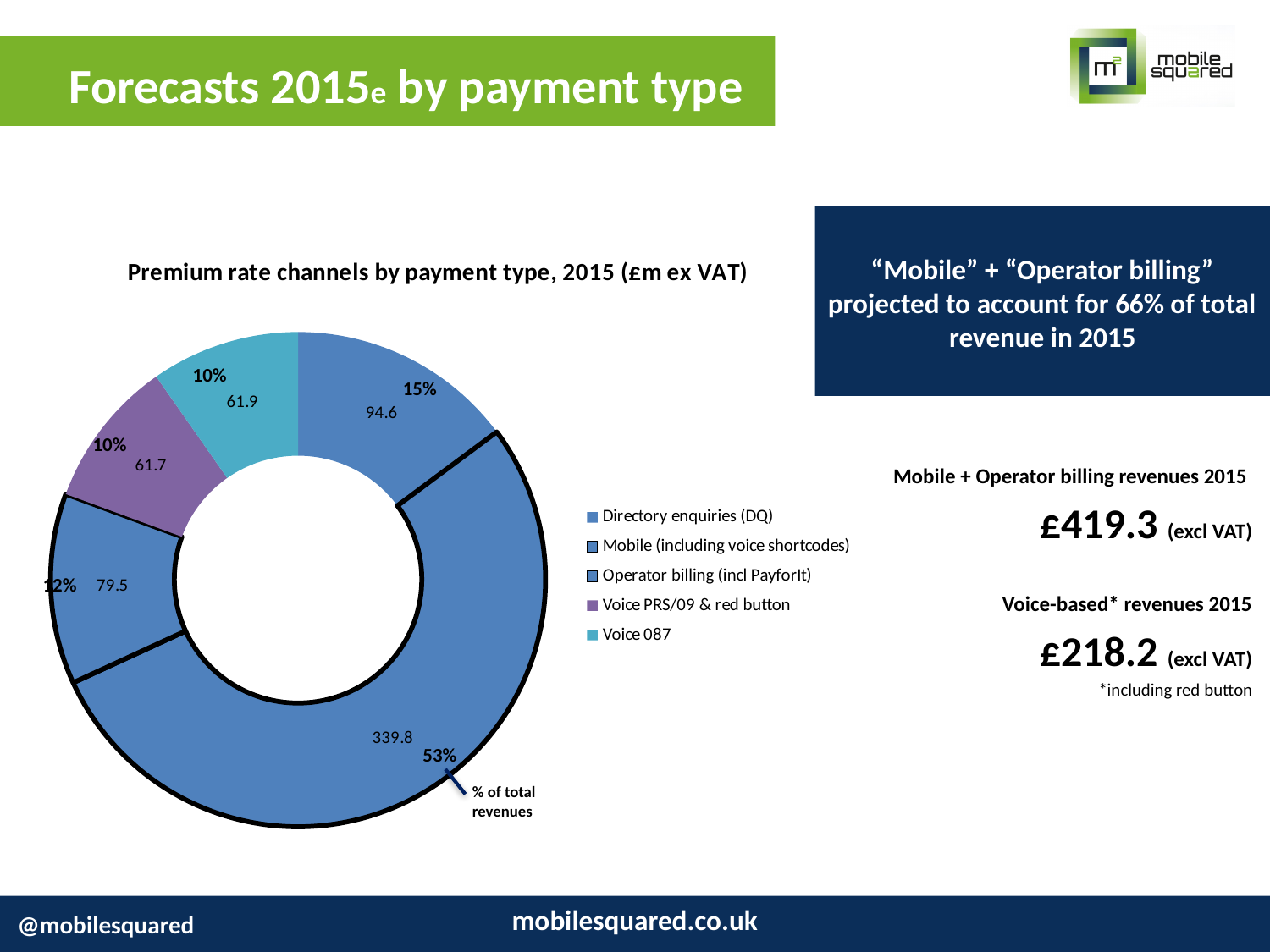
What type of chart is shown on the slide? Doughnut (pie) chart What is the title of the chart? Premium rate channels by payment type, 2015 (£m ex VAT) Which category has the largest share of total revenues? Mobile (including voice shortcodes) Which is larger, the value for Operator billing (incl PayforIt) or the value for Directory enquiries (DQ)? Directory enquiries (DQ) What is the value for Operator billing (incl PayforIt)? 79.5 What is the difference between the values for Mobile (including voice shortcodes) and Directory enquiries (DQ)? 245.2 What is the value for Voice 087? 61.9 What is the value for Mobile (including voice shortcodes)? 339.8 How many categories does the legend list? 5 What percentage of total revenues does Mobile (including voice shortcodes) account for? 53% What is the value for Directory enquiries (DQ)? 94.6 What percentage of total revenues does Directory enquiries (DQ) account for? 15%